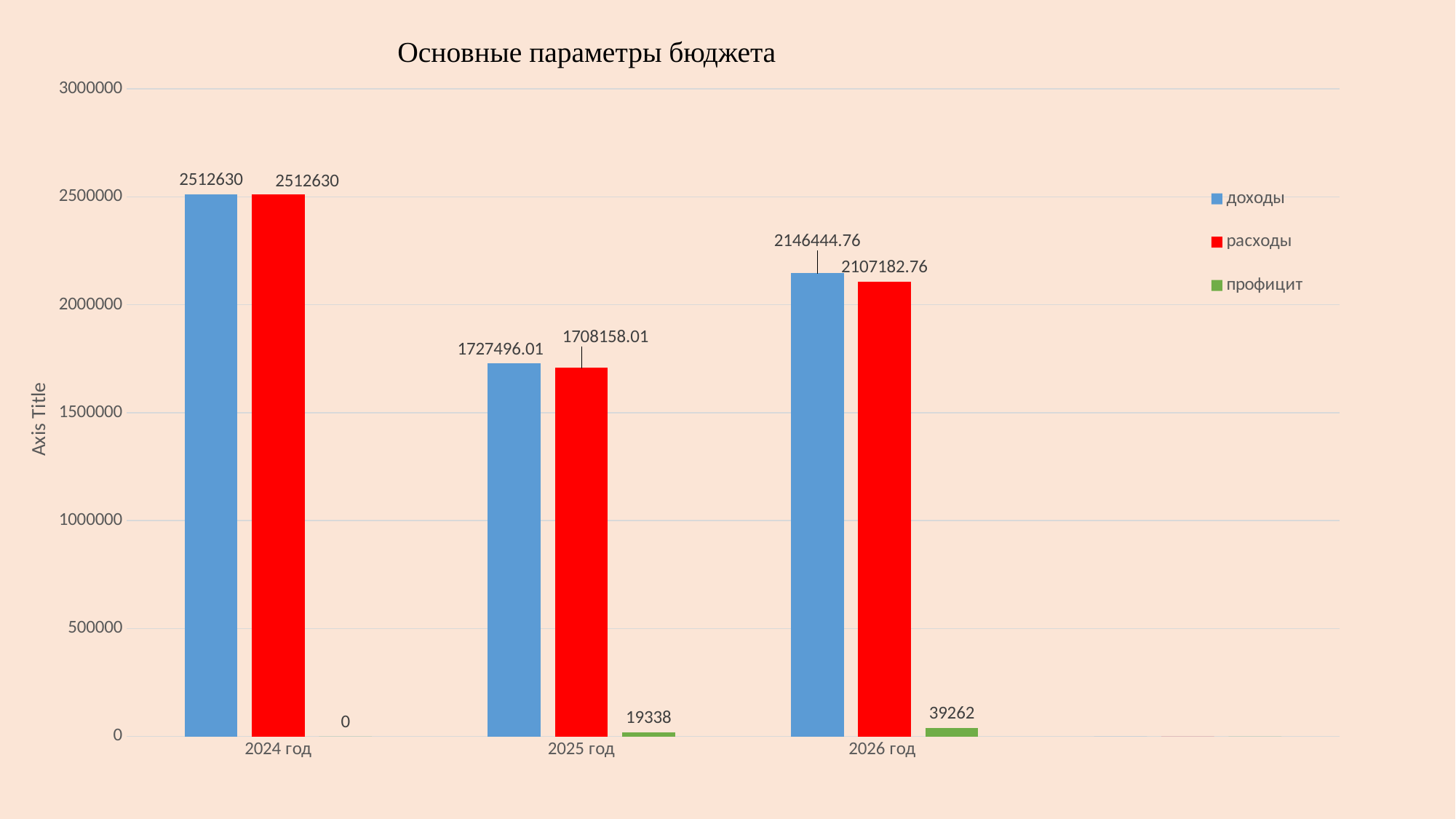
What is the value of доходы for 2024 год? 2512630 What is the title of the chart? Основные параметры бюджета What kind of chart is shown on the slide? bar chart In which year is доходы the lowest? 2025 год What is the value of профицит for 2026 год? 39262 What is the difference between доходы and расходы for 2026 год? 39262 What is the value of расходы for 2025 год? 1708158.01 What is the value of доходы for 2026 год? 2146444.76 How many series does the legend list? 3 Which is larger for 2025 год: доходы or расходы? доходы In which year is профицит the highest? 2026 год What is the difference between доходы for 2024 год and доходы for 2026 год? 366185.24